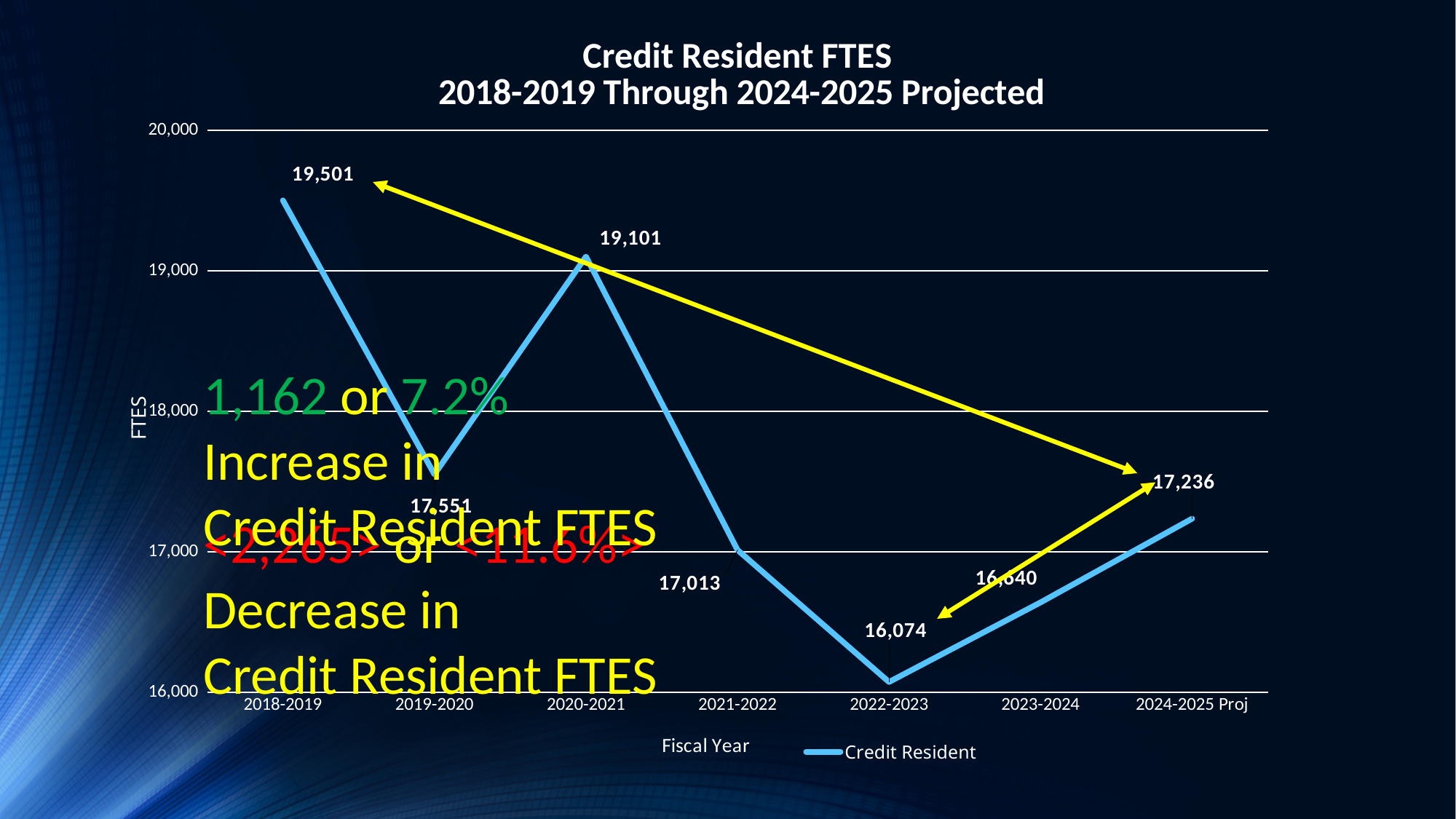
Which is larger, the Credit Resident FTES for 2019-2020 or for 2021-2022? 2019-2020 What is the Credit Resident FTES value for 2018-2019? 19,501 Which fiscal year has the highest Credit Resident FTES? 2018-2019 What type of chart is shown on the slide? line chart What is the Credit Resident FTES value for 2020-2021? 19,101 What is the projected Credit Resident FTES value for 2024-2025? 17,236 Which fiscal year has the lowest Credit Resident FTES? 2022-2023 How many fiscal years are plotted on the x axis? 7 What is the label of the x axis? Fiscal Year What is the difference between the Credit Resident FTES in 2018-2019 and the projected value for 2024-2025? 2,265 Is the Credit Resident FTES value for 2023-2024 greater or less than 17,000? less What is the Credit Resident FTES value for 2022-2023? 16,074